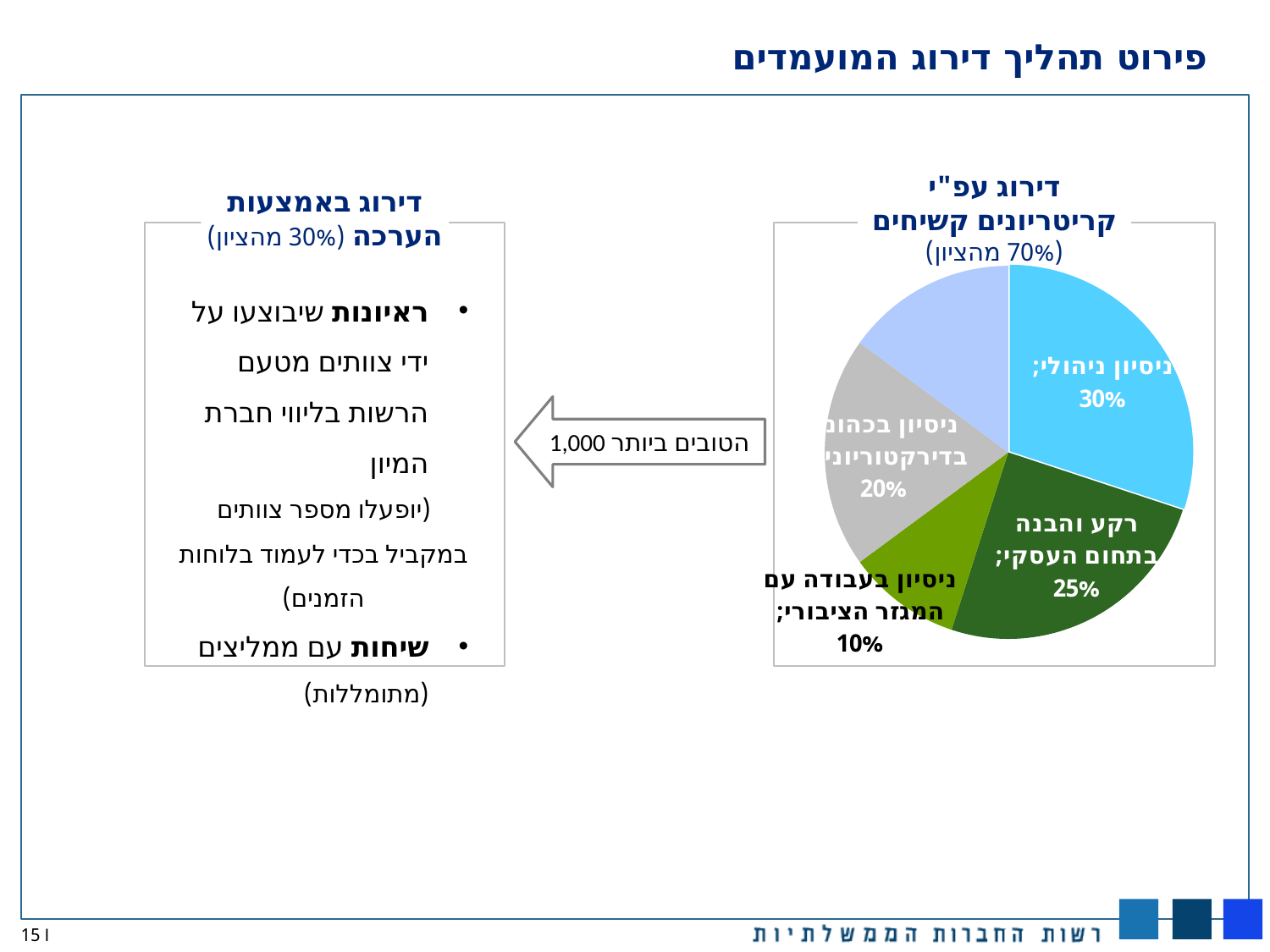
What is the difference in percentage points between the ניסיון ניהולי slice and the רקע והבנה בתחום העסקי slice? 5 Which slice of the pie chart has the largest share? ניסיון ניהולי Which slice is larger: ניסיון בכהונה בדירקטוריון or ניסיון בעבודה עם המגזר הציבורי? ניסיון בכהונה בדירקטוריון What is the title of the pie chart? דירוג עפ"י קריטריונים קשיחים (70% מהציון) What percentage is shown for the slice labelled ניסיון בכהונה בדירקטוריון? 20% Which slice of the pie chart has the smallest share? ניסיון בעבודה עם המגזר הציבורי What percentage is shown for the slice labelled ניסיון ניהולי? 30% What percentage is shown for the slice labelled ניסיון בעבודה עם המגזר הציבורי? 10% How many slices does the pie chart have? 5 What share of the total score does the pie chart's title say the hard criteria account for? 70% What kind of chart is shown on the slide? pie chart What percentage is shown for the slice labelled רקע והבנה בתחום העסקי? 25%